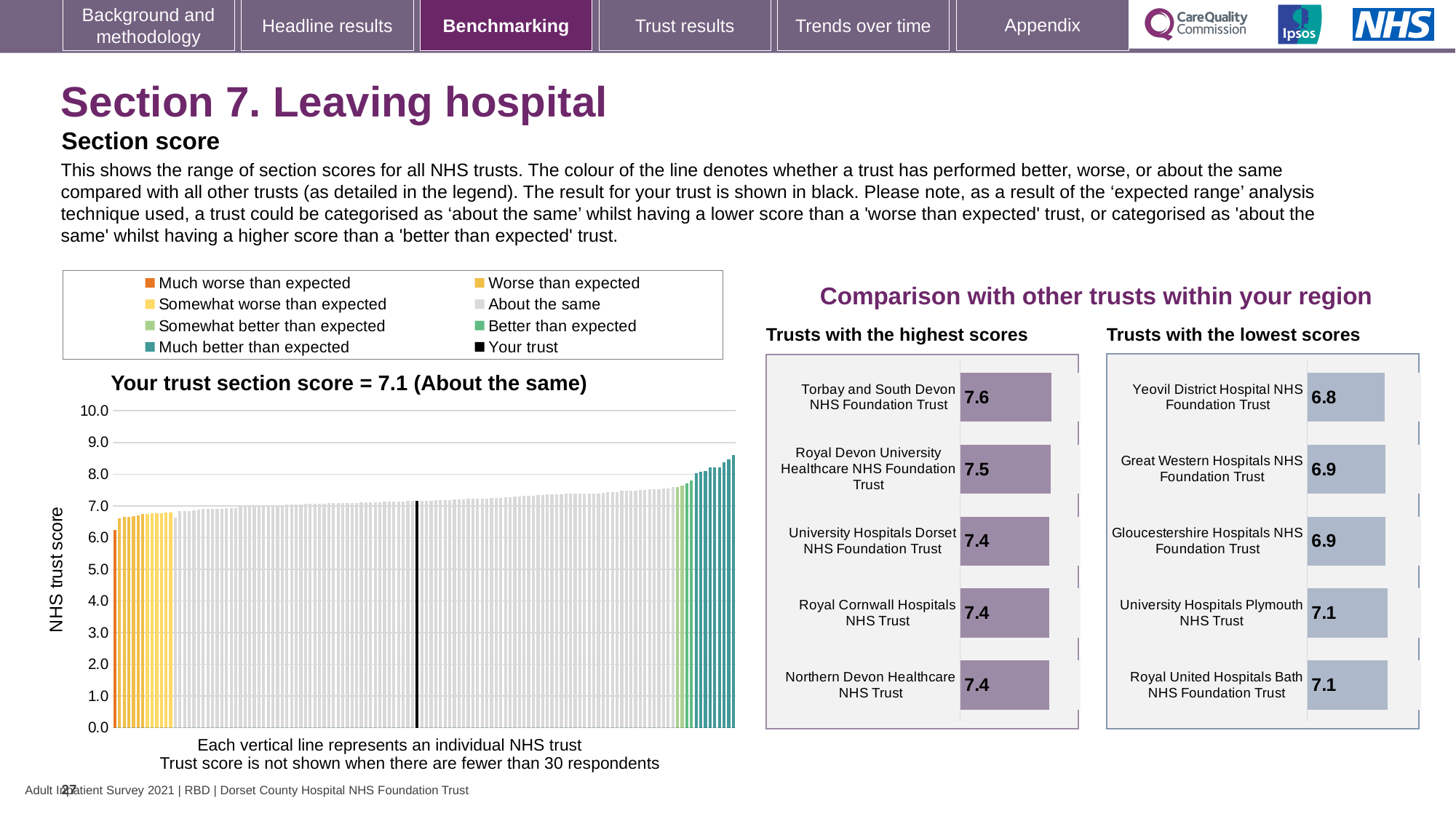
In the 'Trusts with the lowest scores' chart, which trust has the lowest score? Yeovil District Hospital NHS Foundation Trust How many trusts are shown in the 'Trusts with the lowest scores' chart? 5 In the 'Trusts with the highest scores' chart, what is the difference between the scores of Torbay and South Devon NHS Foundation Trust and Northern Devon Healthcare NHS Trust? 0.2 In the main chart on the left, what is the section score for your trust? 7.1 In the 'Trusts with the highest scores' chart, what is the score for Torbay and South Devon NHS Foundation Trust? 7.6 In the main chart on the left, is the value of the tallest bar greater or less than 8.0? greater How many entries does the legend of the main chart on the left list? 8 In the 'Trusts with the lowest scores' chart, what is the score for University Hospitals Plymouth NHS Trust? 7.1 In the 'Trusts with the lowest scores' chart, what is the score for Yeovil District Hospital NHS Foundation Trust? 6.8 In the 'Trusts with the lowest scores' chart, which has the larger score: Great Western Hospitals NHS Foundation Trust or Royal United Hospitals Bath NHS Foundation Trust? Royal United Hospitals Bath NHS Foundation Trust In the 'Trusts with the highest scores' chart, what is the score for Royal Devon University Healthcare NHS Foundation Trust? 7.5 In the 'Trusts with the highest scores' chart, which trust has the highest score? Torbay and South Devon NHS Foundation Trust